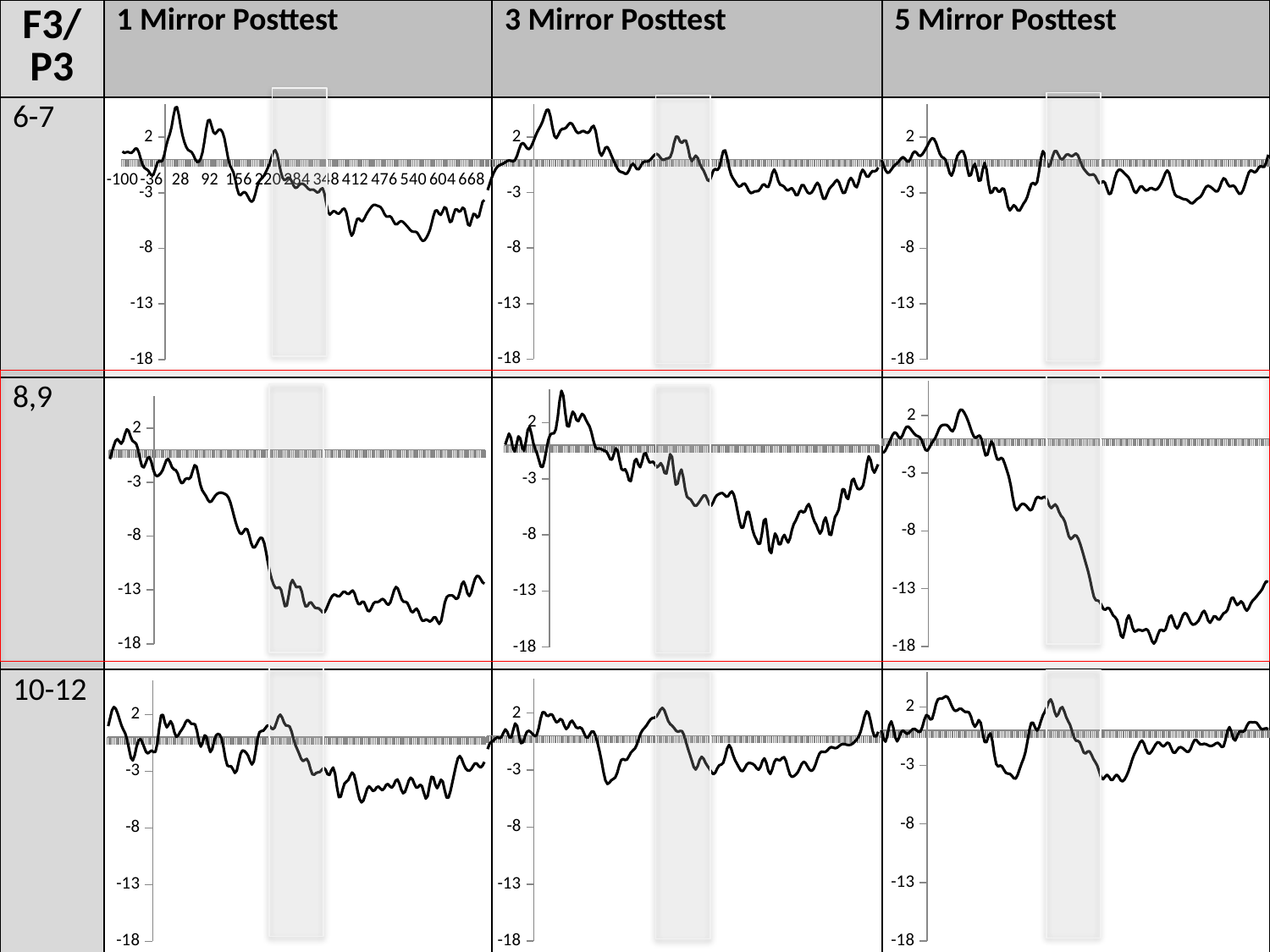
What are the three column headings above the charts? 1 Mirror Posttest, 3 Mirror Posttest, 5 Mirror Posttest In the 8,9 row, 3 Mirror Posttest chart, is the lowest point of the line greater or less than -13? greater What is the lowest value labelled on the vertical axis of the charts? -18 What kind of chart is used in each panel of the grid on this slide? line chart In the 1 Mirror Posttest column, which row's chart reaches the lowest value: 6-7, 8,9 or 10-12? 8,9 In the 8,9 row, 5 Mirror Posttest chart, is the lowest point of the line greater or less than -13? less What is the first x-axis label shown on the 6-7 row, 1 Mirror Posttest chart? -100 In the 10-12 row, 1 Mirror Posttest chart, is the lowest point of the line greater or less than -3? less In the 8,9 row, which chart reaches a lower minimum: 3 Mirror Posttest or 5 Mirror Posttest? 5 Mirror Posttest In the 8,9 row, 1 Mirror Posttest chart, do the values generally rise or fall along the x axis? fall How many charts are shown on the slide? 9